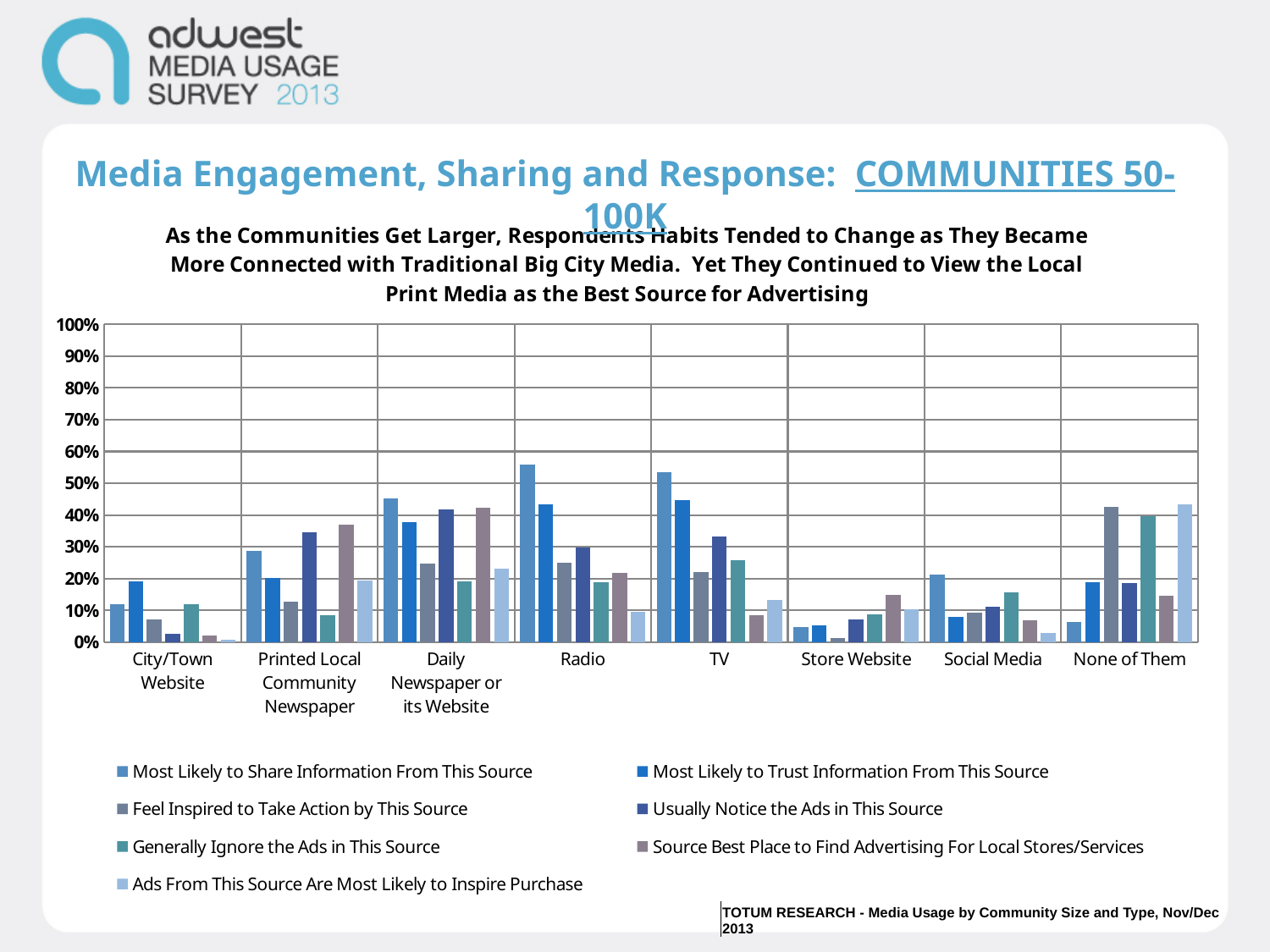
Which category has the highest value in the 'Generally Ignore the Ads in This Source' series? None of Them Is the value for None of Them in the 'Ads From This Source Are Most Likely to Inspire Purchase' series greater or less than 40%? greater How many categories are shown along the x axis of the chart? 8 For Social Media, which is larger: 'Most Likely to Share Information From This Source' or 'Most Likely to Trust Information From This Source'? Most Likely to Share Information From This Source What is the highest percentage shown on the chart's y axis? 100% Which category has the lowest value in the 'Most Likely to Trust Information From This Source' series? Store Website How many series does the chart's legend list? 7 What kind of chart is shown on the slide? bar chart Is the value for Printed Local Community Newspaper in the 'Source Best Place to Find Advertising For Local Stores/Services' series greater or less than 30%? greater Is the value for Radio in the 'Most Likely to Share Information From This Source' series greater or less than 50%? greater Which category has the highest value in the 'Source Best Place to Find Advertising For Local Stores/Services' series? Daily Newspaper or its Website